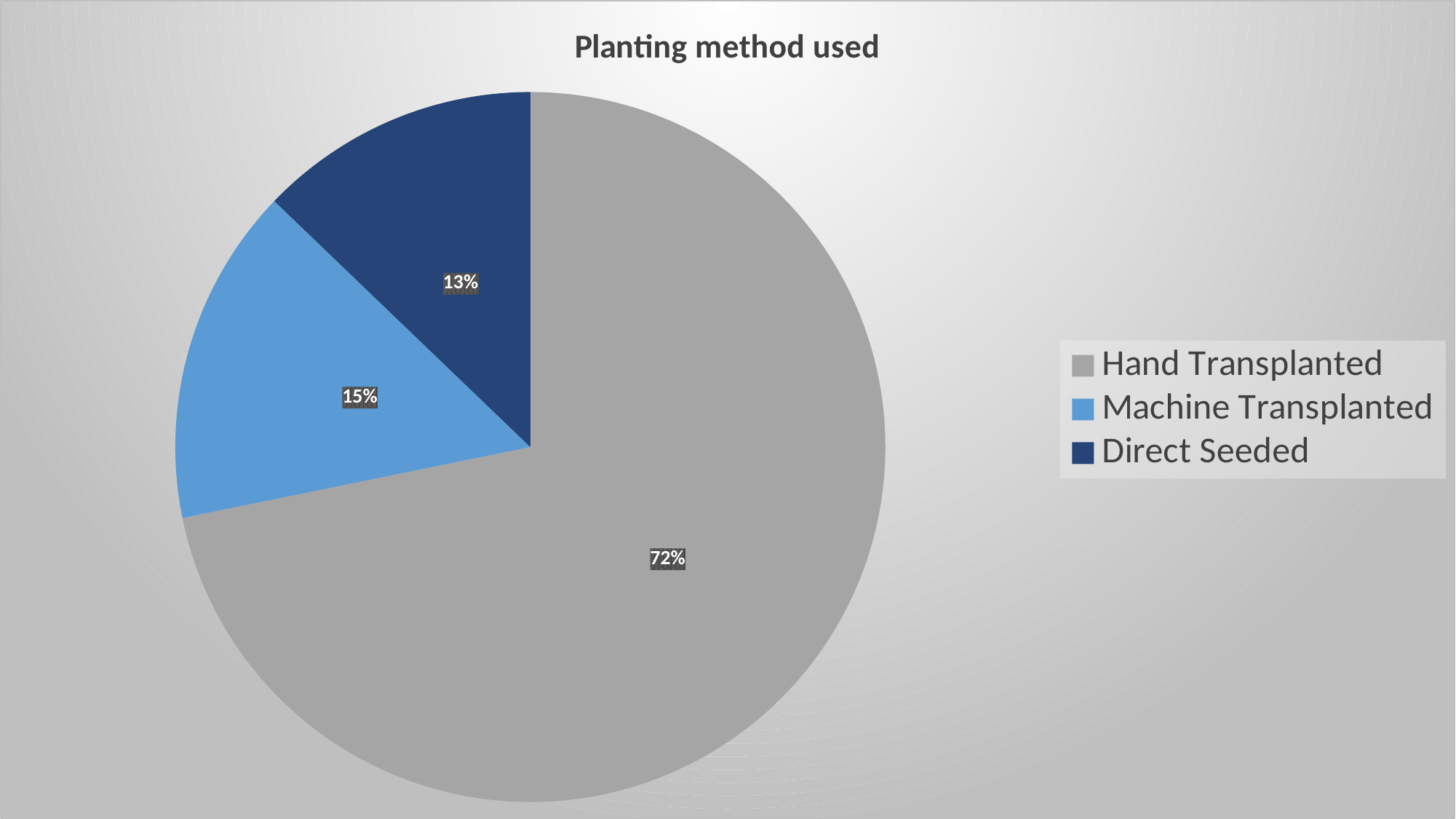
What colour is the Direct Seeded slice? dark blue What share of the pie is Hand Transplanted? 72% What share of the pie is Direct Seeded? 13% How many slices does the pie chart have? 3 Which planting method has the largest slice? Hand Transplanted What kind of chart is shown on the slide? pie chart Which is larger, the Machine Transplanted slice or the Direct Seeded slice? Machine Transplanted How many entries does the legend list? 3 What is the difference in percentage points between Hand Transplanted and Machine Transplanted? 57 What is the title of the chart? Planting method used What share of the pie is Machine Transplanted? 15% Which planting method has the smallest slice? Direct Seeded